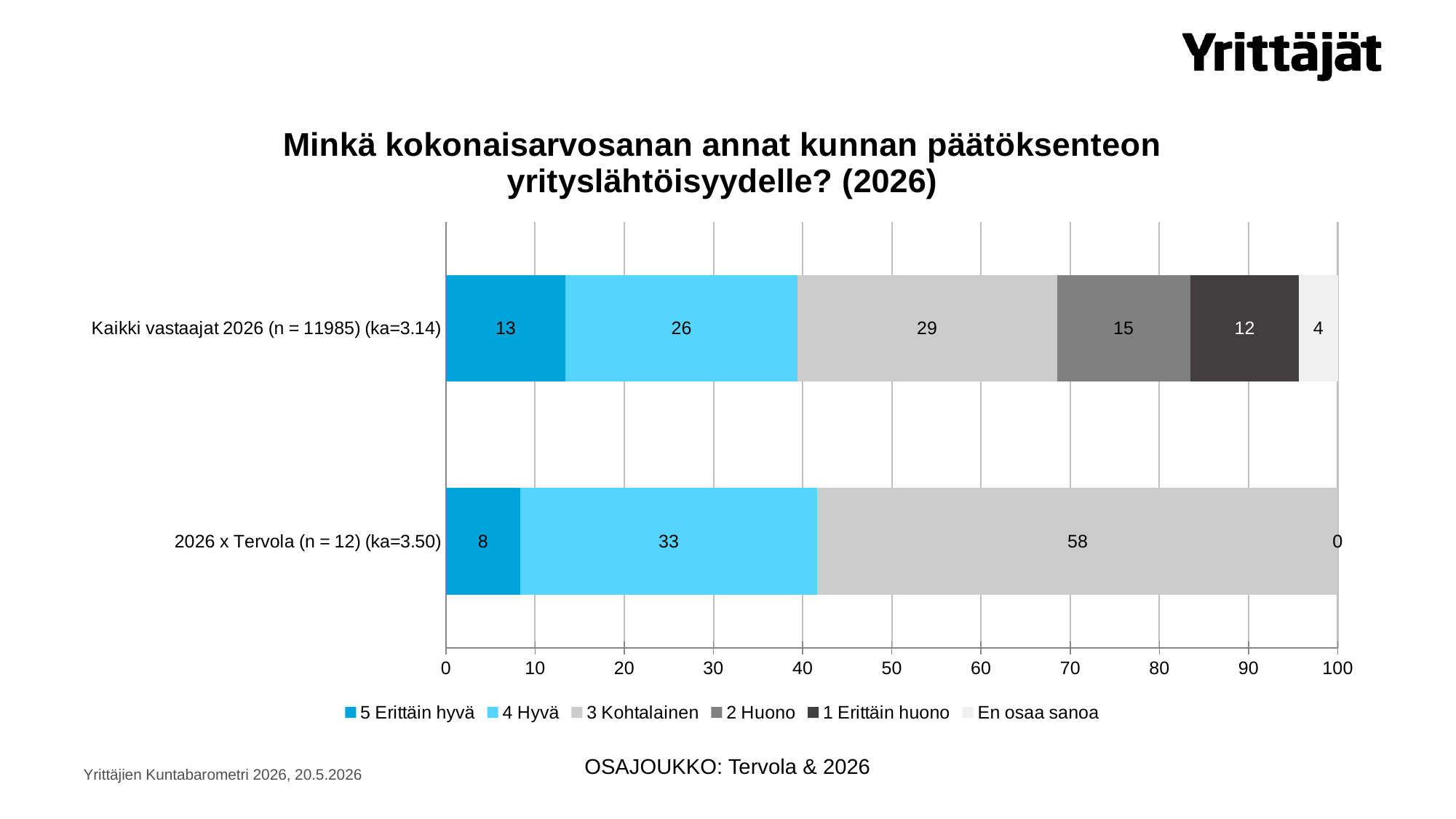
What is the difference between the '4 Hyvä' values of '2026 x Tervola (n = 12) (ka=3.50)' and 'Kaikki vastaajat 2026 (n = 11985) (ka=3.14)'? 7 What is the total of the stacked bar for 'Kaikki vastaajat 2026 (n = 11985) (ka=3.14)'? 99 Which category has the higher value for '3 Kohtalainen'? 2026 x Tervola (n = 12) (ka=3.50) Which series has the largest value in the 'Kaikki vastaajat 2026 (n = 11985) (ka=3.14)' bar? 3 Kohtalainen What is the value of '1 Erittäin huono' for 'Kaikki vastaajat 2026 (n = 11985) (ka=3.14)'? 12 What is the value of '4 Hyvä' for 'Kaikki vastaajat 2026 (n = 11985) (ka=3.14)'? 26 How many series does the legend list? 6 What kind of chart is shown on the slide? stacked bar chart What is the value of '5 Erittäin hyvä' for '2026 x Tervola (n = 12) (ka=3.50)'? 8 What is the title of the chart? Minkä kokonaisarvosanan annat kunnan päätöksenteon yrityslähtöisyydelle? (2026) How many categories (bars) are plotted in the chart? 2 What is the value of '3 Kohtalainen' for '2026 x Tervola (n = 12) (ka=3.50)'? 58